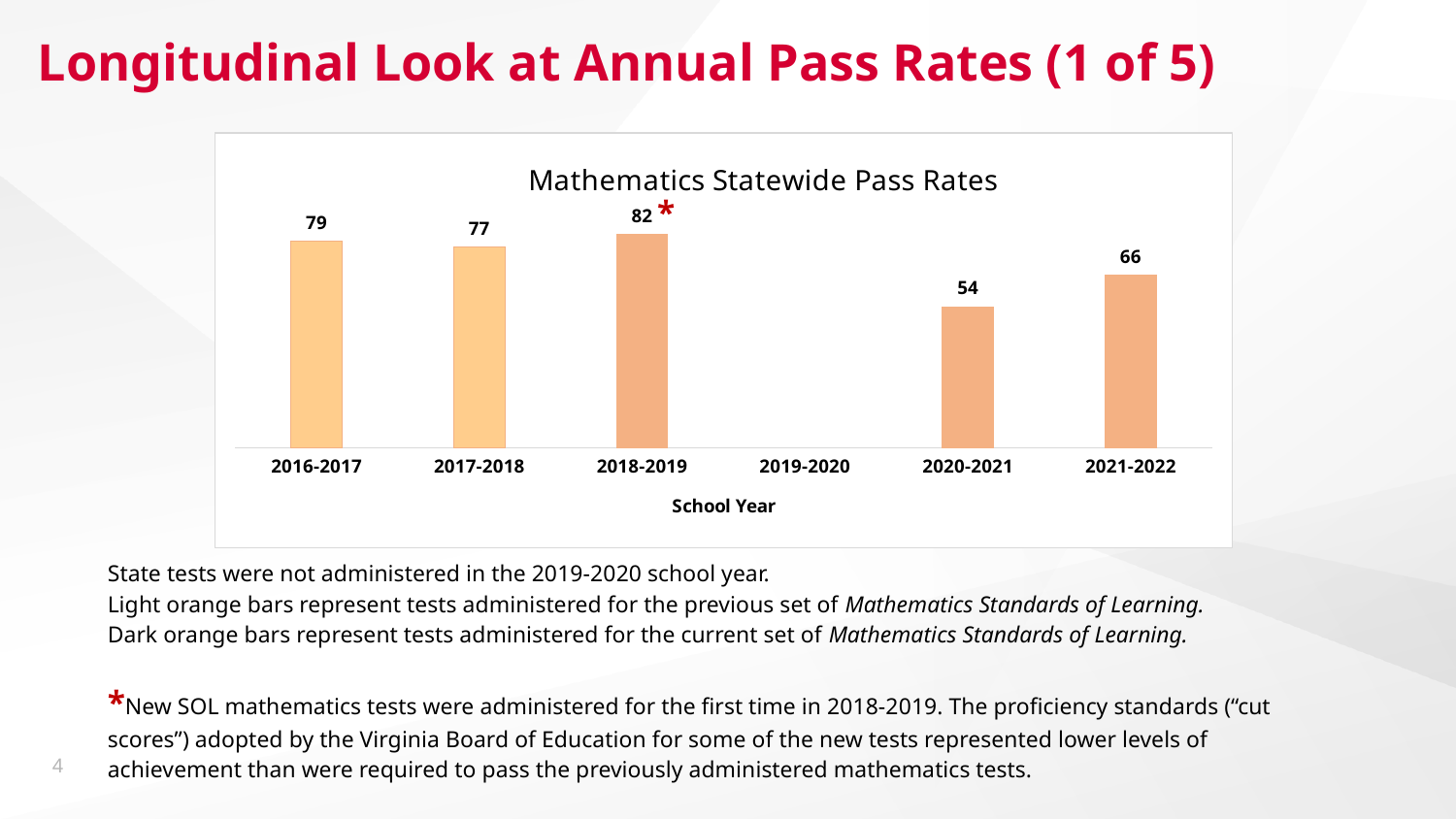
Which school year has the highest mathematics statewide pass rate? 2018-2019 Which has a higher pass rate, 2016-2017 or 2017-2018? 2016-2017 Do the pass rates rise or fall from 2020-2021 to 2021-2022? Rise What is the mathematics statewide pass rate for 2021-2022? 66 What is the difference between the pass rates for 2018-2019 and 2020-2021? 28 What kind of chart is shown on the slide? Bar chart What is the difference between the pass rates for 2021-2022 and 2020-2021? 12 What is the mathematics statewide pass rate for 2020-2021? 54 Which school year has the lowest plotted mathematics statewide pass rate? 2020-2021 What is the title of the chart? Mathematics Statewide Pass Rates How many school years are labeled on the x axis of the chart? 6 What is the mathematics statewide pass rate for 2016-2017? 79